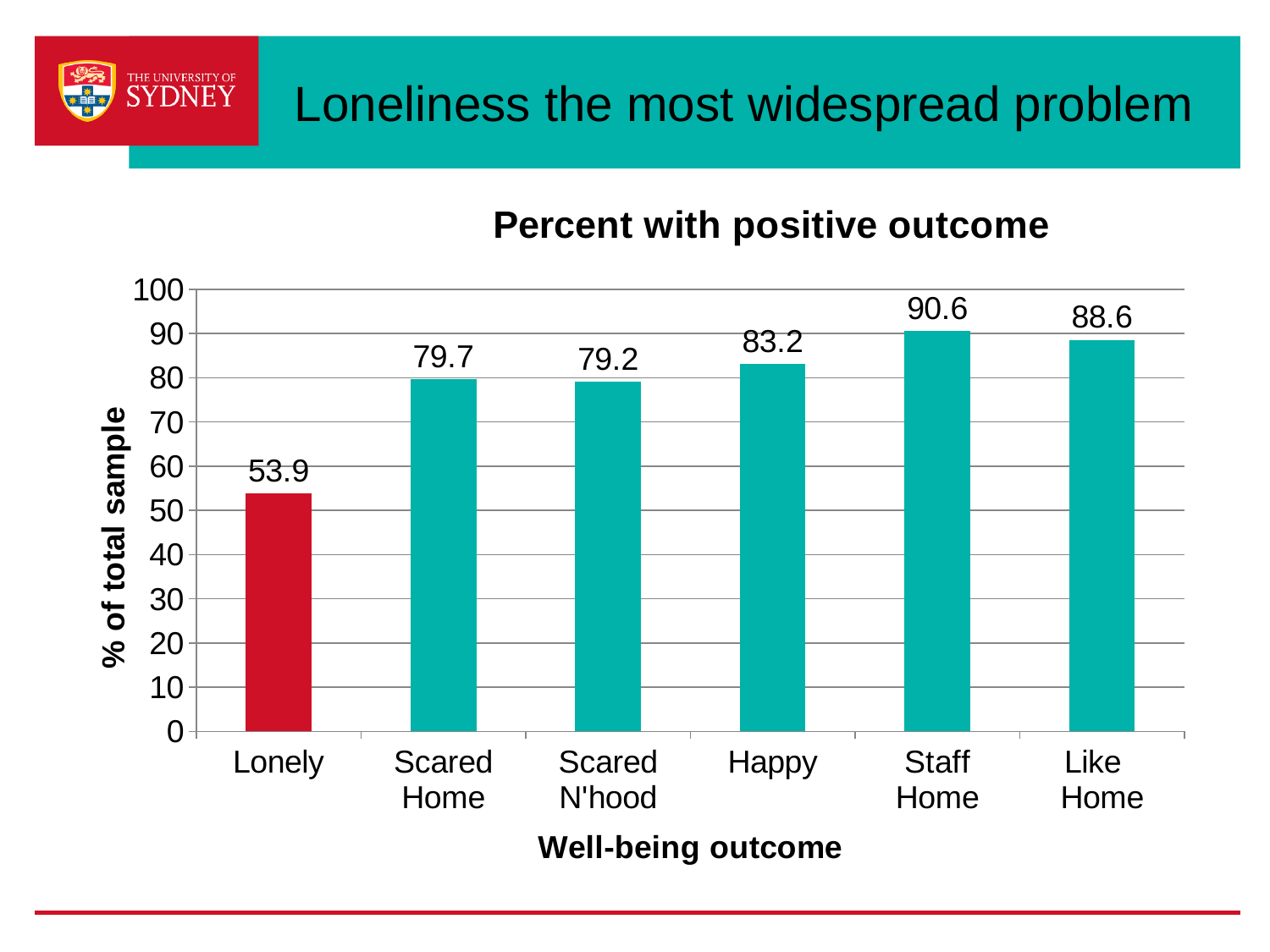
Is the value for Lonely greater or less than 60? less What is the title of the chart? Percent with positive outcome How many categories are shown on the x axis? 6 What is the value for Lonely? 53.9 Which category has the highest value? Staff Home Which category has the lowest value? Lonely What is the difference between the values for Like Home and Happy? 5.4 Which is larger, the value for Happy or the value for Scared Home? Happy What is the value for Scared N'hood? 79.2 What is the difference between the values for Staff Home and Lonely? 36.7 What kind of chart is shown on the slide? bar chart What is the value for Staff Home? 90.6